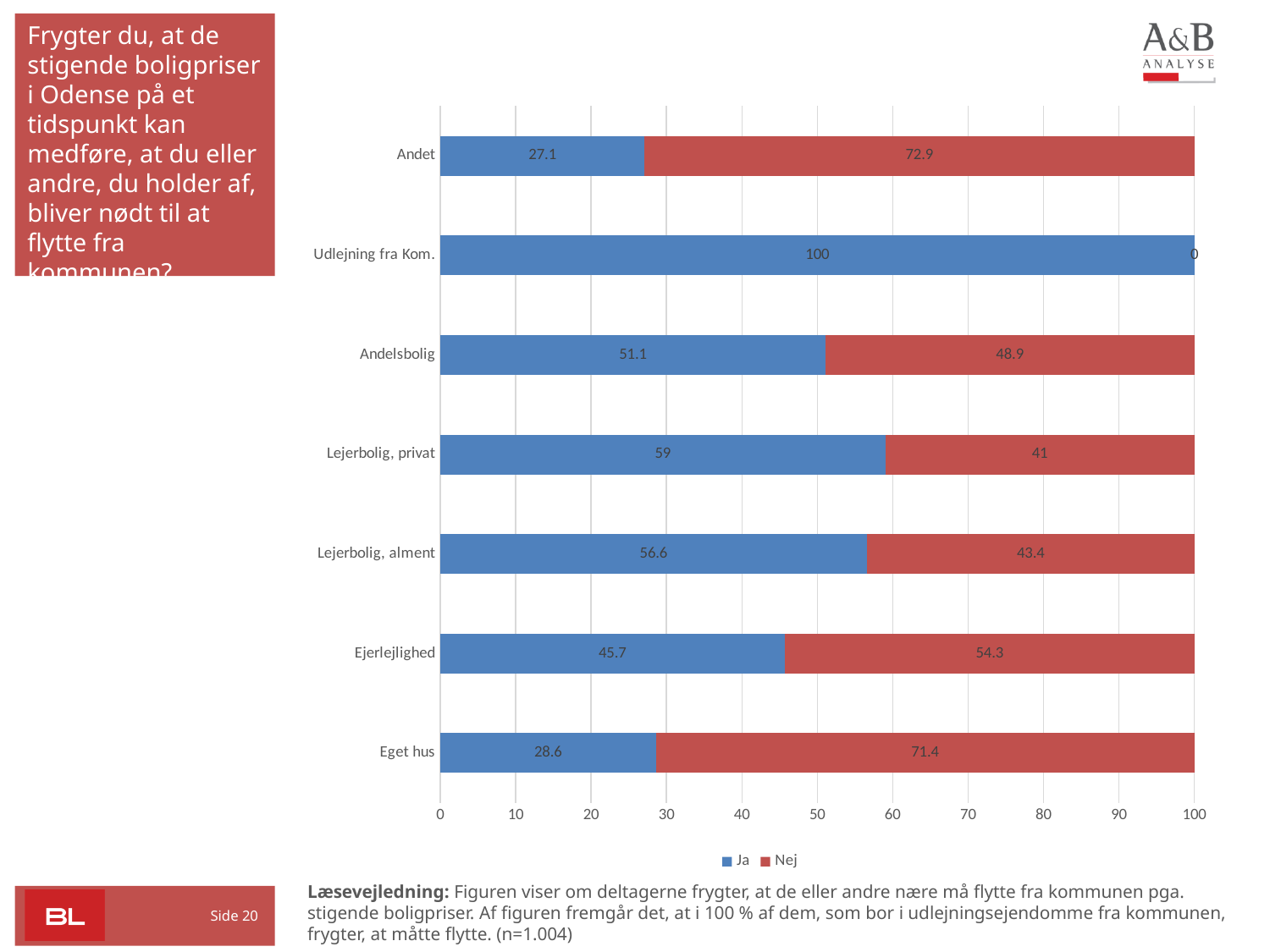
What is the 'Ja' value for Andelsbolig? 51.1 How many categories are shown on the y axis? 7 Which category has the lowest 'Ja' value? Andet What is the 'Nej' value for Eget hus? 71.4 What kind of chart is shown? Stacked bar chart Which category has the highest 'Ja' value? Udlejning fra Kom. What is the difference between the 'Nej' values for Andet and Ejerlejlighed? 18.6 What is the 'Ja' value for Lejerbolig, alment? 56.6 What is the total of the stacked bar for Lejerbolig, privat? 100 Which is larger, the 'Ja' value for Lejerbolig, privat or the 'Ja' value for Ejerlejlighed? Lejerbolig, privat Which colour represents the 'Nej' series? Red How many series does the legend list? 2